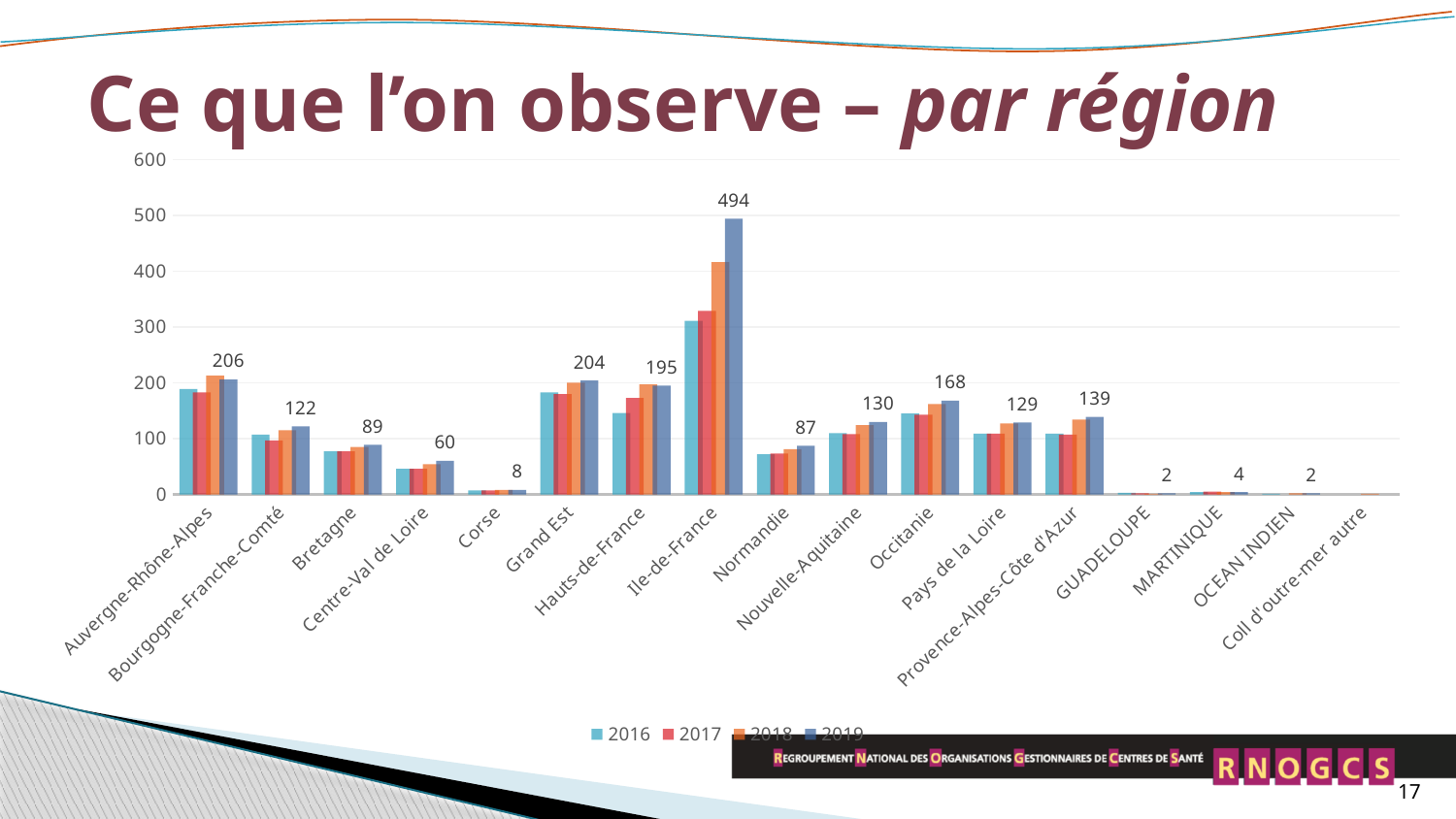
What is the difference between the 2019 values for Ile-de-France and Auvergne-Rhône-Alpes? 288 Which region has the highest 2019 value? Ile-de-France What is the 2019 value for Auvergne-Rhône-Alpes? 206 Among Corse, Bretagne and Normandie, which has the lowest 2019 value? Corse How many series does the legend list? 4 What is the 2019 value for Occitanie? 168 How many regions (categories) are shown on the x axis? 17 Is the 2016 value for Hauts-de-France greater or less than 100? greater Which has the larger 2019 value, Grand Est or Hauts-de-France? Grand Est Do the values for Ile-de-France rise or fall from 2016 to 2019? rise What is the 2019 value for Ile-de-France? 494 What is the 2019 value for Corse? 8